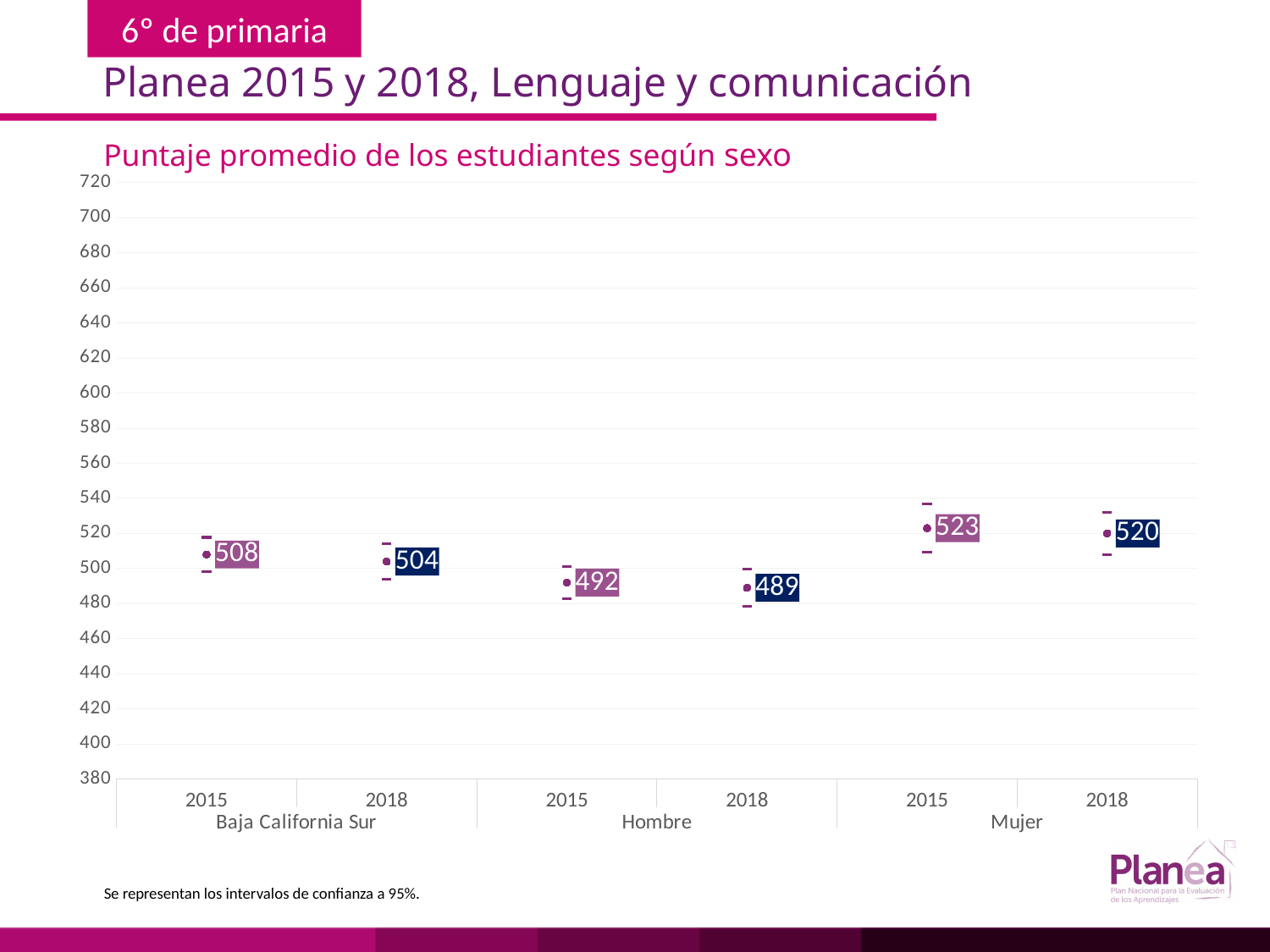
What is the average score for Baja California Sur in 2015? 508 Which group and year has the lowest average score? Hombre 2018 Which is larger, the Hombre score in 2015 or the Baja California Sur score in 2018? Baja California Sur 2018 By how much did the Baja California Sur score change from 2015 to 2018? 4 What is the title of the chart? Puntaje promedio de los estudiantes según sexo What is the average score for Mujer in 2015? 523 What is the average score for Mujer in 2018? 520 Is the Hombre score in 2018 greater or less than 500? less Which group and year has the highest average score? Mujer 2015 What is the difference between the Mujer score in 2015 and the Hombre score in 2015? 31 How many data points are plotted on the chart? 6 What is the average score for Hombre in 2018? 489